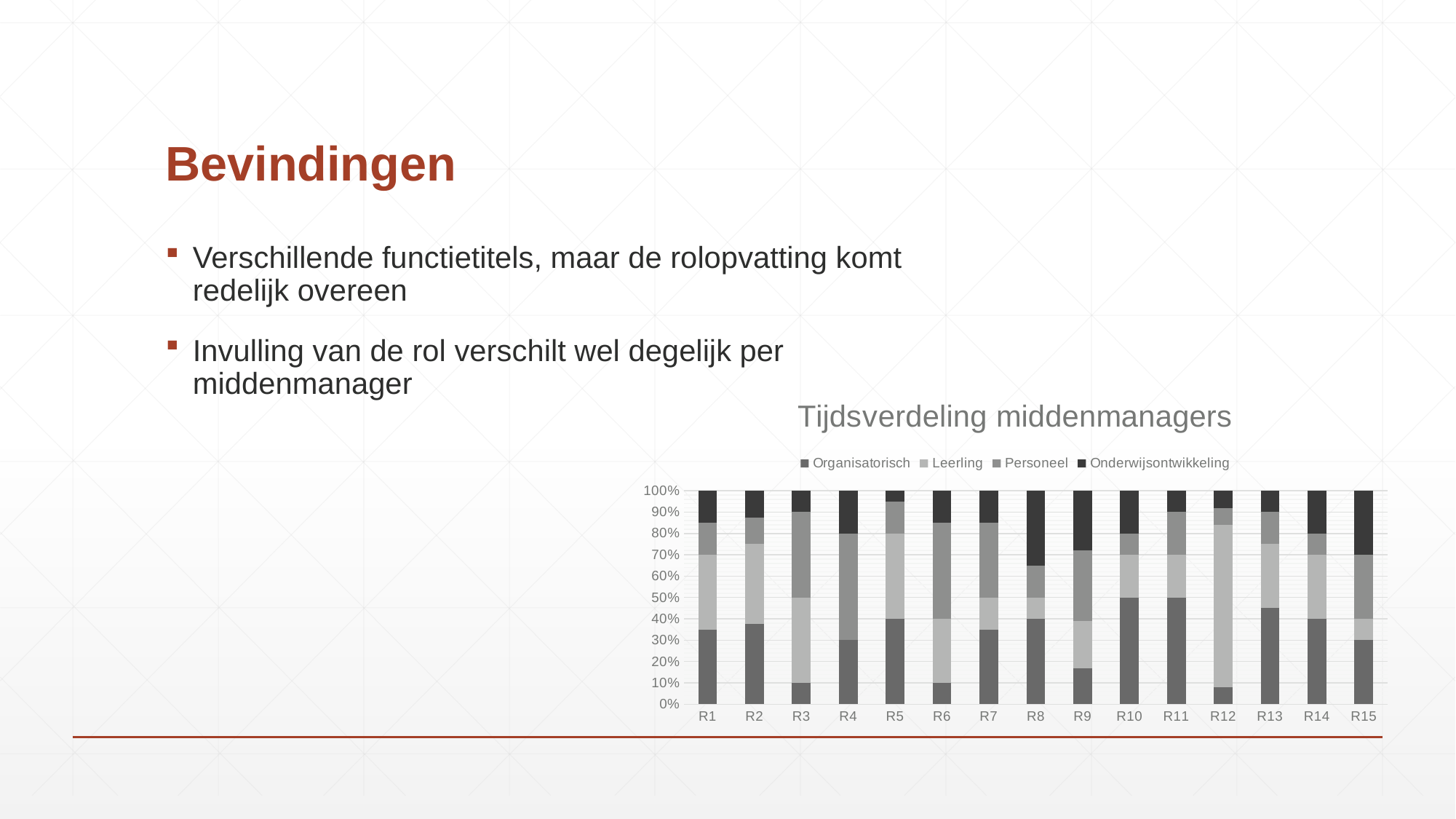
What is the title of the chart? Tijdsverdeling middenmanagers What is the Organisatorisch value for R10? 50% Is the Organisatorisch value for R3 greater or less than 20%? less Which series is listed first in the chart legend? Organisatorisch What kind of chart is shown on the slide? Stacked bar chart Which category has the largest Onderwijsontwikkeling segment? R8 How many categories (R1 to R15) are plotted on the x axis of the chart? 15 How many series does the legend of the chart list? 4 What is the total of the stacked bar for R1? 100% Which has the larger Organisatorisch value, R13 or R9? R13 Is the Organisatorisch value for R10 greater or less than 40%? greater